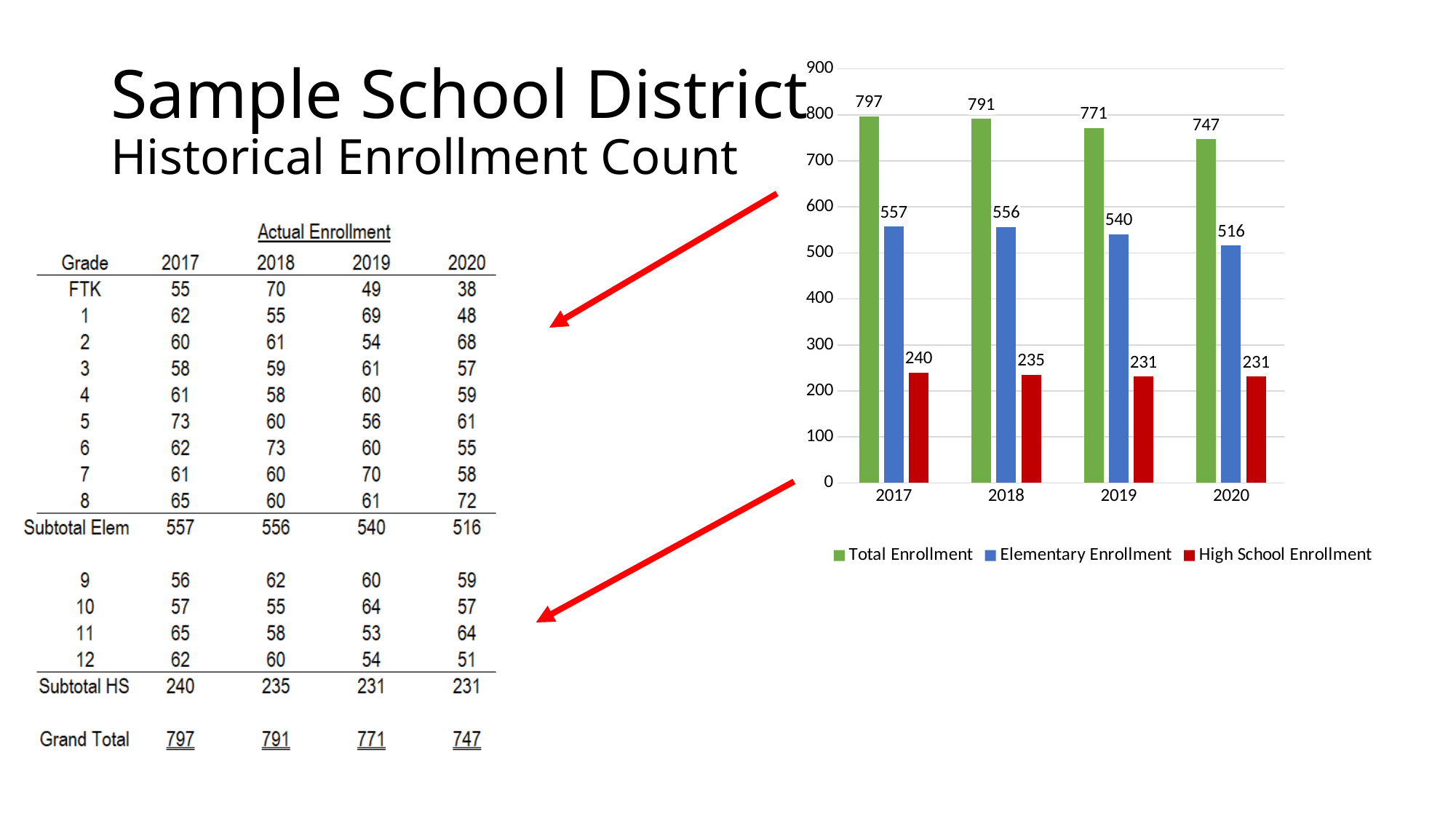
Which is larger, Elementary Enrollment in 2018 or in 2019? 2018 What is the High School Enrollment value for 2018? 235 What is the Total Enrollment value for 2017? 797 How many years are shown on the x axis of the chart? 4 What kind of chart is shown on the slide? bar chart What is the difference between Total Enrollment in 2017 and 2020? 50 Does Total Enrollment rise or fall from 2017 to 2020? fall What is the Elementary Enrollment value for 2020? 516 Which year has the lowest Elementary Enrollment? 2020 Is the High School Enrollment value for 2019 greater or less than 300? less Which year has the highest Total Enrollment? 2017 How many series does the chart legend list? 3